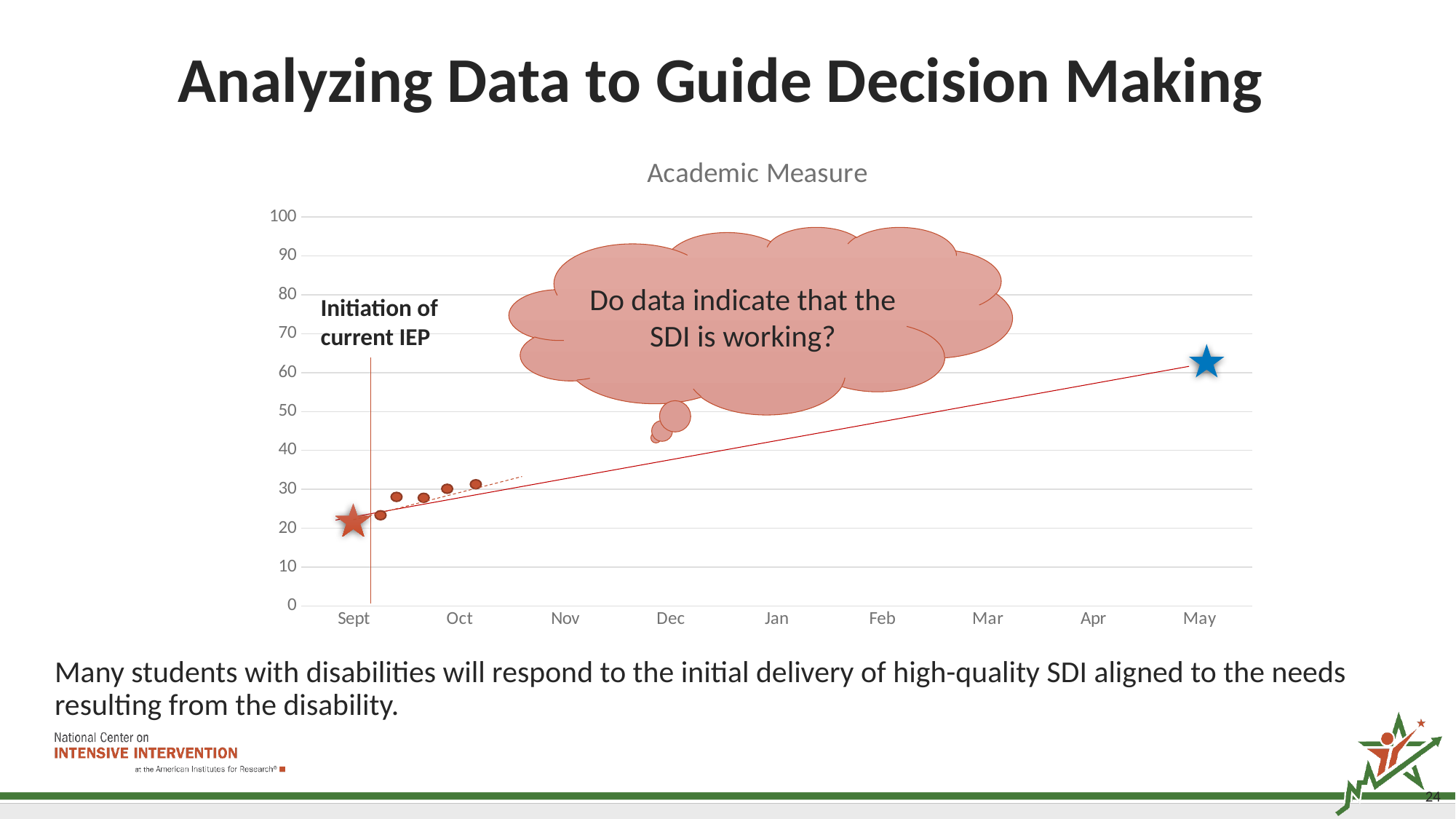
Which star marks a higher value, the red star at Sept or the blue star at May? the blue star at May What does the vertical line near Sept mark, according to the label on the chart? Initiation of current IEP How many months are labeled on the x axis of the chart? 9 What is the first month shown on the x axis? Sept Is the value of the blue star at May greater or less than 50? greater Is the value of the red star at Sept greater or less than 30? less Do the plotted data points rise or fall from Sept toward Oct? rise What is the title of the chart? Academic Measure Are the plotted data points near Oct greater or less than 40? less What is the highest value shown on the y axis? 100 What question is written in the thought bubble on the chart? Do data indicate that the SDI is working?